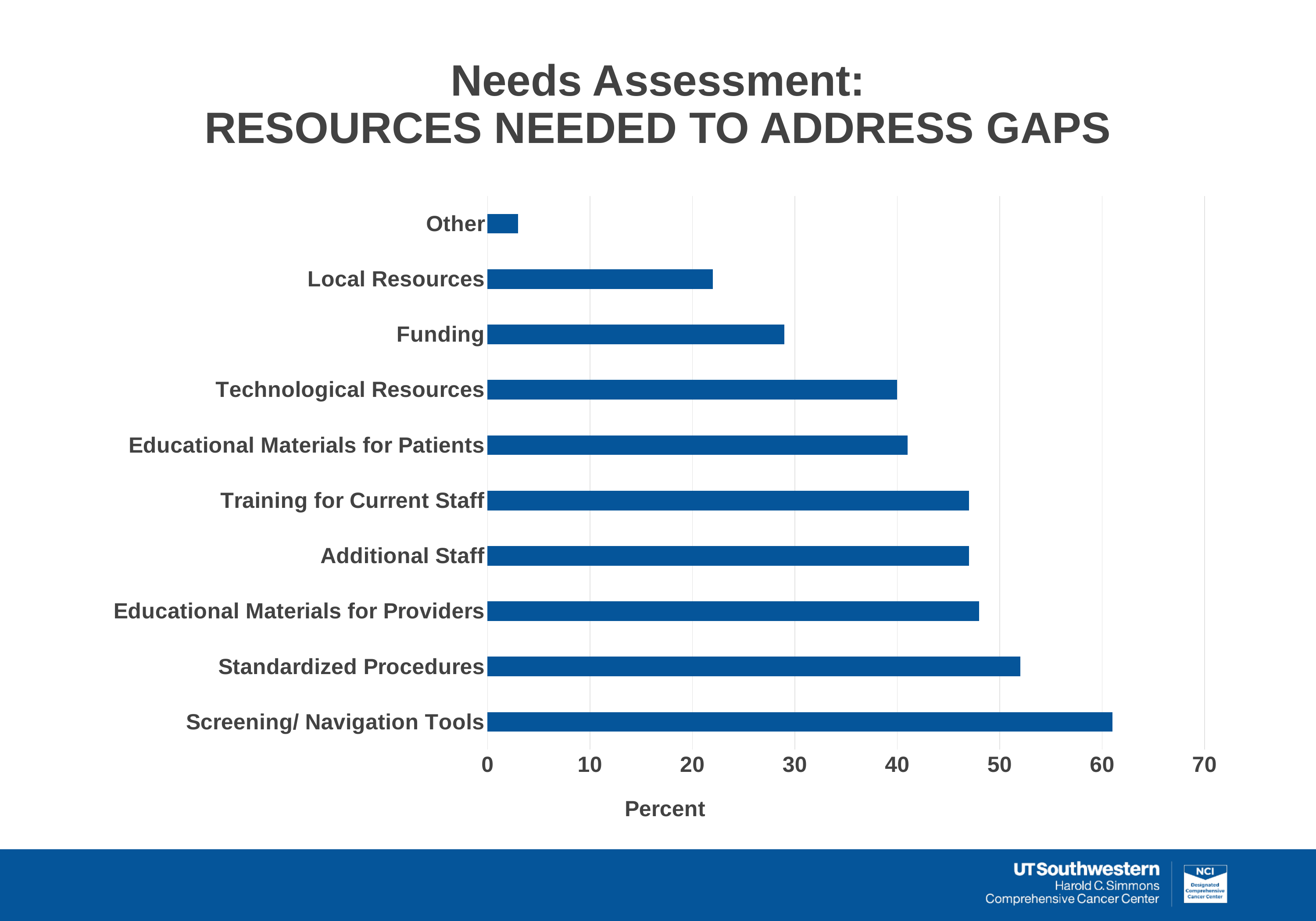
Which category has the lowest value? Other Which is larger, the value for Funding or the value for Technological Resources? Technological Resources Which category has the highest value? Screening/ Navigation Tools How many categories are plotted in the chart? 10 Is the value for Standardized Procedures greater or less than 50? greater Is the value for Screening/ Navigation Tools greater or less than 60? greater Is the value for Local Resources greater or less than 20? greater Which is larger, the value for Standardized Procedures or the value for Educational Materials for Patients? Standardized Procedures What kind of chart is shown on the slide? bar chart What is the label on the horizontal axis of the chart? Percent